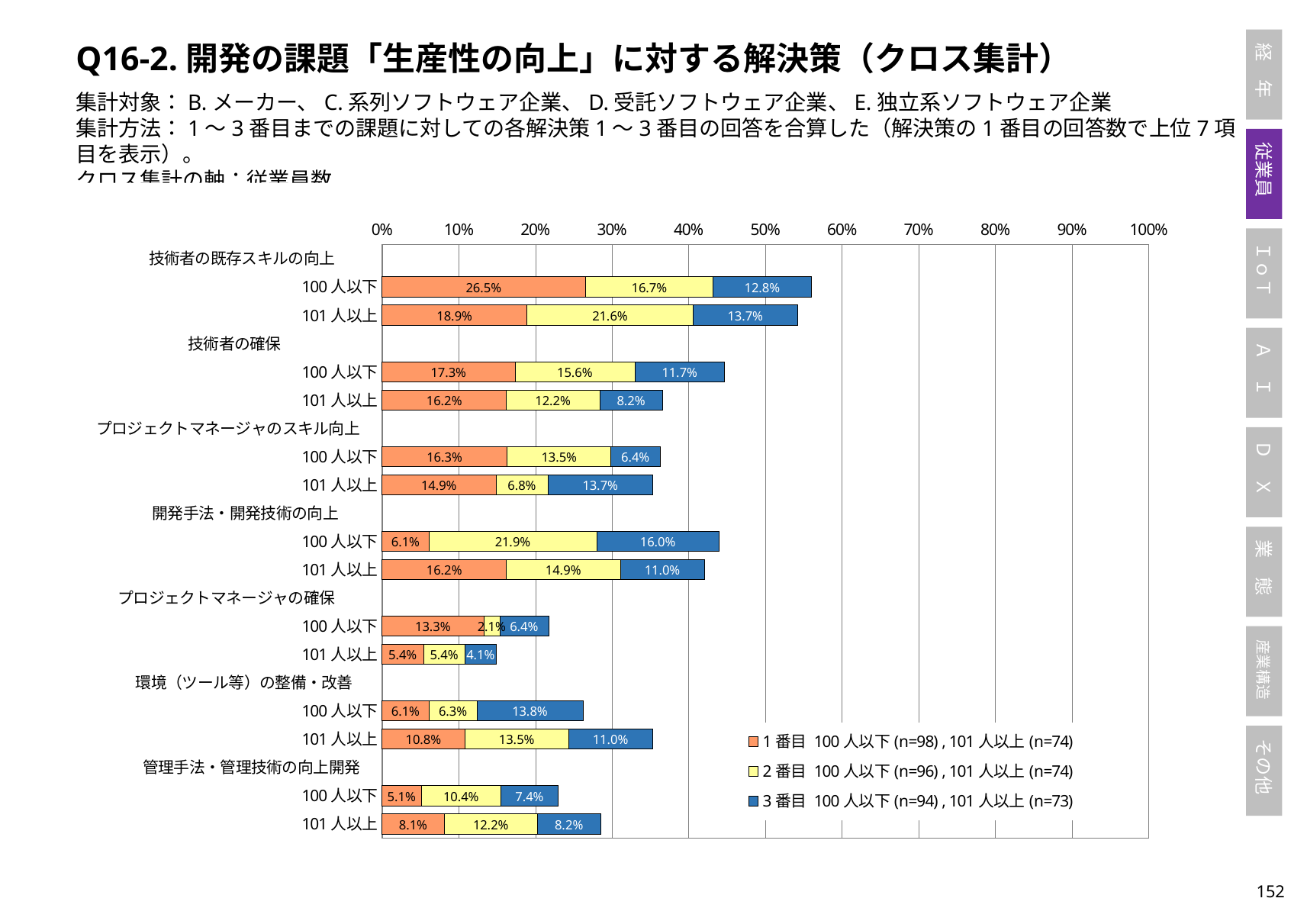
What type of chart is shown on the slide? Stacked bar chart What is the difference between the 1番目 values for 100人以下 and 101人以上 under 技術者の既存スキルの向上? 7.6% Which is larger: the 3番目 value for 100人以下 under 環境（ツール等）の整備・改善 or the 3番目 value for 101人以上 under the same item? 100人以下 (13.8%) What is the total of the stacked bar for 100人以下 under 技術者の既存スキルの向上? 56.0% What is the 1番目 value for 100人以下 under 技術者の既存スキルの向上? 26.5% Is the total of the stacked bar for 100人以下 under 技術者の確保 greater or less than 40%? greater What is the total of the stacked bar for 101人以上 under プロジェクトマネージャの確保? 14.9% How many series does the legend list? 3 What is the 3番目 value for 101人以上 under プロジェクトマネージャのスキル向上? 13.7% What is the sample size (n) for 101人以上 in the 3番目 series according to the legend? n=73 Which 1番目 value is the lowest across all bars? 5.1% (管理手法・管理技術の向上開発, 100人以下) What is the 2番目 value for 100人以下 under 開発手法・開発技術の向上? 21.9%